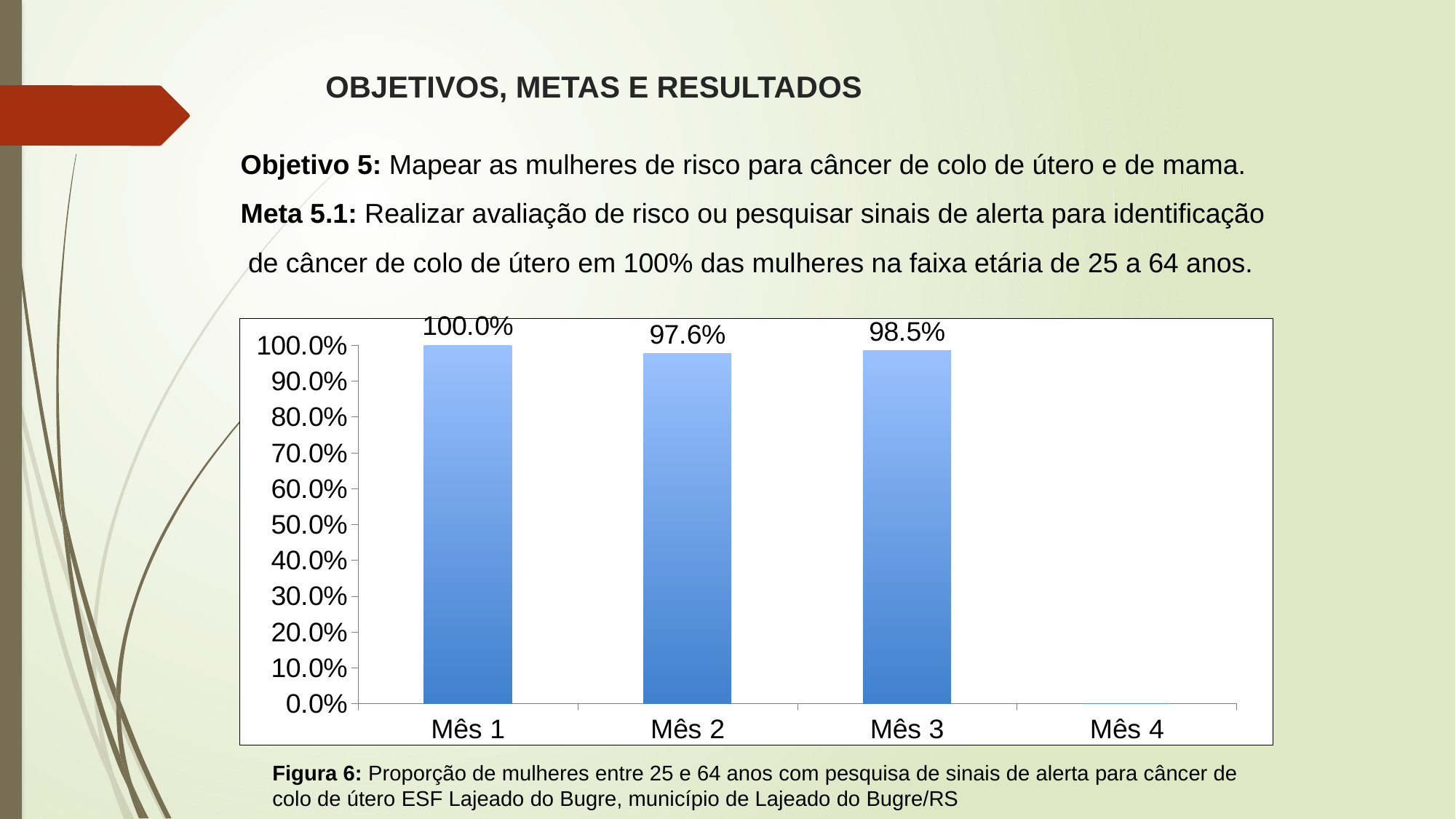
What is the difference between the values for Mês 3 and Mês 2? 0.9% How many month categories are shown on the x axis? 4 What is the value for Mês 1? 100.0% Among Mês 1, Mês 2 and Mês 3, which has the lowest value? Mês 2 Which is larger, the value for Mês 2 or the value for Mês 3? Mês 3 Does the value rise or fall from Mês 1 to Mês 2? fall Which month has the highest value in the chart? Mês 1 What is the value for Mês 3? 98.5% What kind of chart is shown on the slide? bar chart Is the value for Mês 2 greater or less than 90.0%? greater What is the difference between the values for Mês 1 and Mês 2? 2.4% What is the value for Mês 2? 97.6%